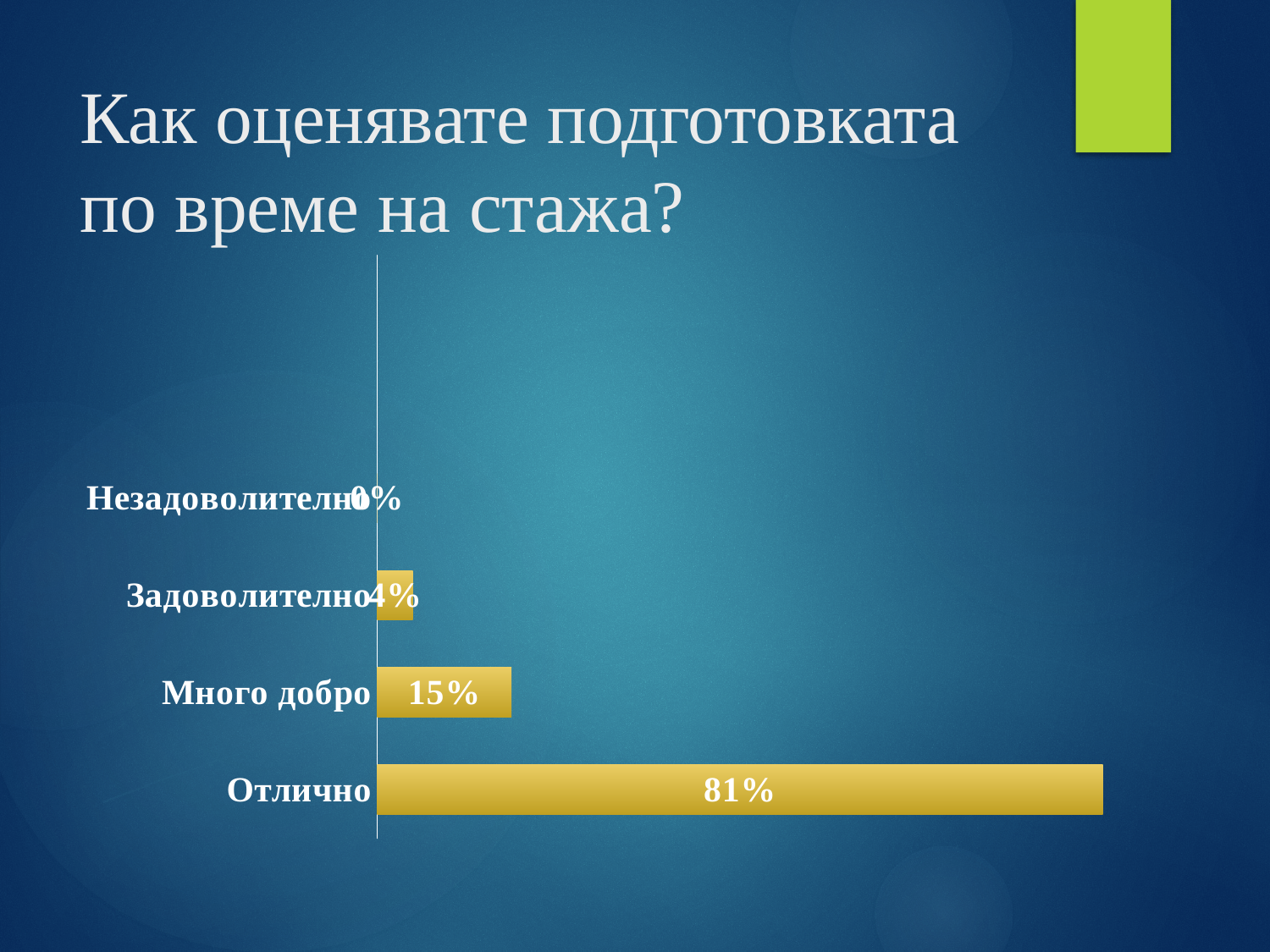
How many categories are shown in the chart? 4 Which category has the highest value? Отлично What is the title of the slide containing the chart? Как оценявате подготовката по време на стажа? What is the value for Незадоволително? 0% What kind of chart is shown on the slide? Bar chart What is the difference between the values for Много добро and Задоволително? 11% What is the value for Отлично? 81% What is the value for Много добро? 15% What is the value for Задоволително? 4% Which is larger, the value for Много добро or the value for Задоволително? Много добро What is the difference between the values for Отлично and Много добро? 66% Which category has the lowest value? Незадоволително